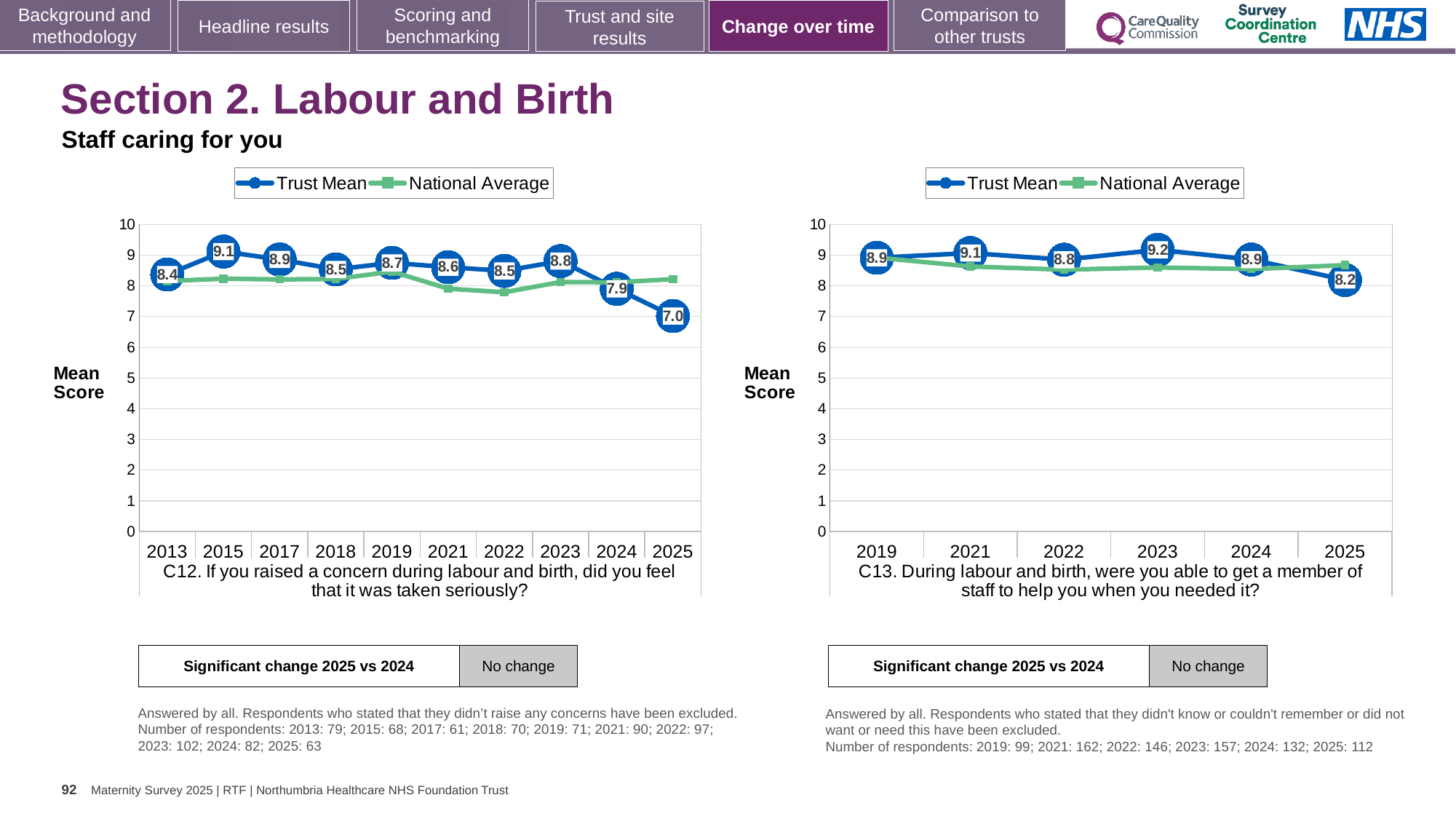
In the right chart (C13), which year has the lowest Trust Mean? 2025 In the left chart (C12), is the National Average for 2013 greater or less than 7? greater In the left chart (C12), what is the Trust Mean for 2025? 7.0 In the left chart (C12), what is the difference between the Trust Mean for 2024 and 2025? 0.9 How many series does the legend of the left chart (C12) list? 2 In the left chart (C12), which year has the lowest Trust Mean? 2025 What kind of chart is the right chart (C13)? Line chart In the right chart (C13), which is larger, the Trust Mean for 2021 or for 2025? 2021 In the left chart (C12), what is the Trust Mean for 2015? 9.1 In the right chart (C13), what is the Trust Mean for 2023? 9.2 How many years are shown on the x axis of the right chart (C13)? 6 In the left chart (C12), which year has the highest Trust Mean? 2015